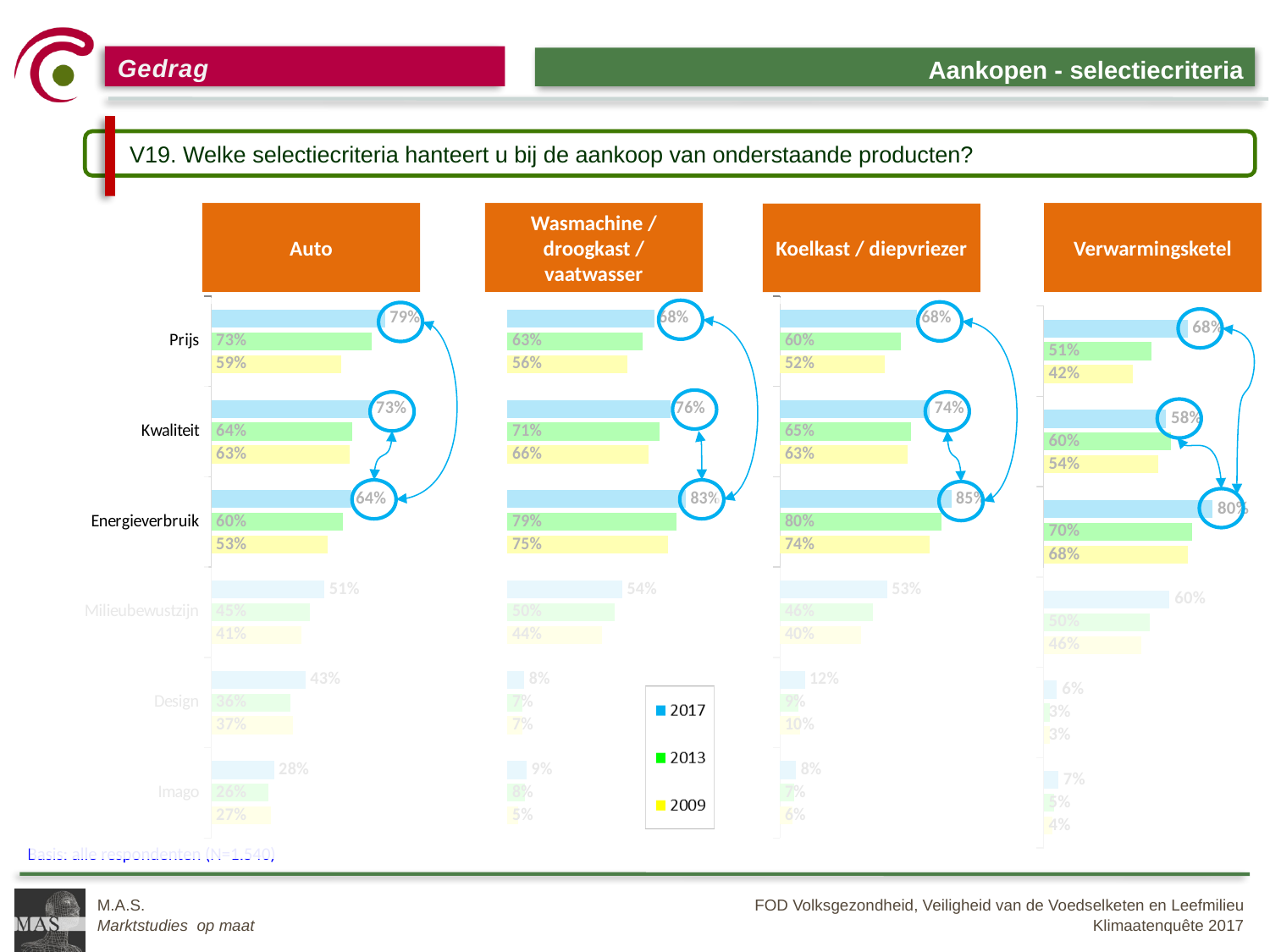
In the Auto chart, what is the 2017 value for Prijs? 79% Which colour represents the 2009 series in the legend? Yellow In the Verwarmingsketel chart, which is larger for Kwaliteit: the 2017 value or the 2013 value? 2013 In the Koelkast / diepvriezer chart, what is the 2013 value for Energieverbruik? 80% How many series does the legend list? 3 In the Wasmachine / droogkast / vaatwasser chart, what is the 2009 value for Imago? 5% What kind of chart is used for the Auto data? Bar chart In the Koelkast / diepvriezer chart, what is the difference between the 2017 and 2009 values for Prijs? 16% In the Wasmachine / droogkast / vaatwasser chart, which criterion has the highest 2017 value? Energieverbruik How many criteria (categories) are shown in each chart? 6 In the Auto chart, which criterion has the lowest 2017 value? Imago In the Verwarmingsketel chart, what is the 2009 value for Kwaliteit? 54%